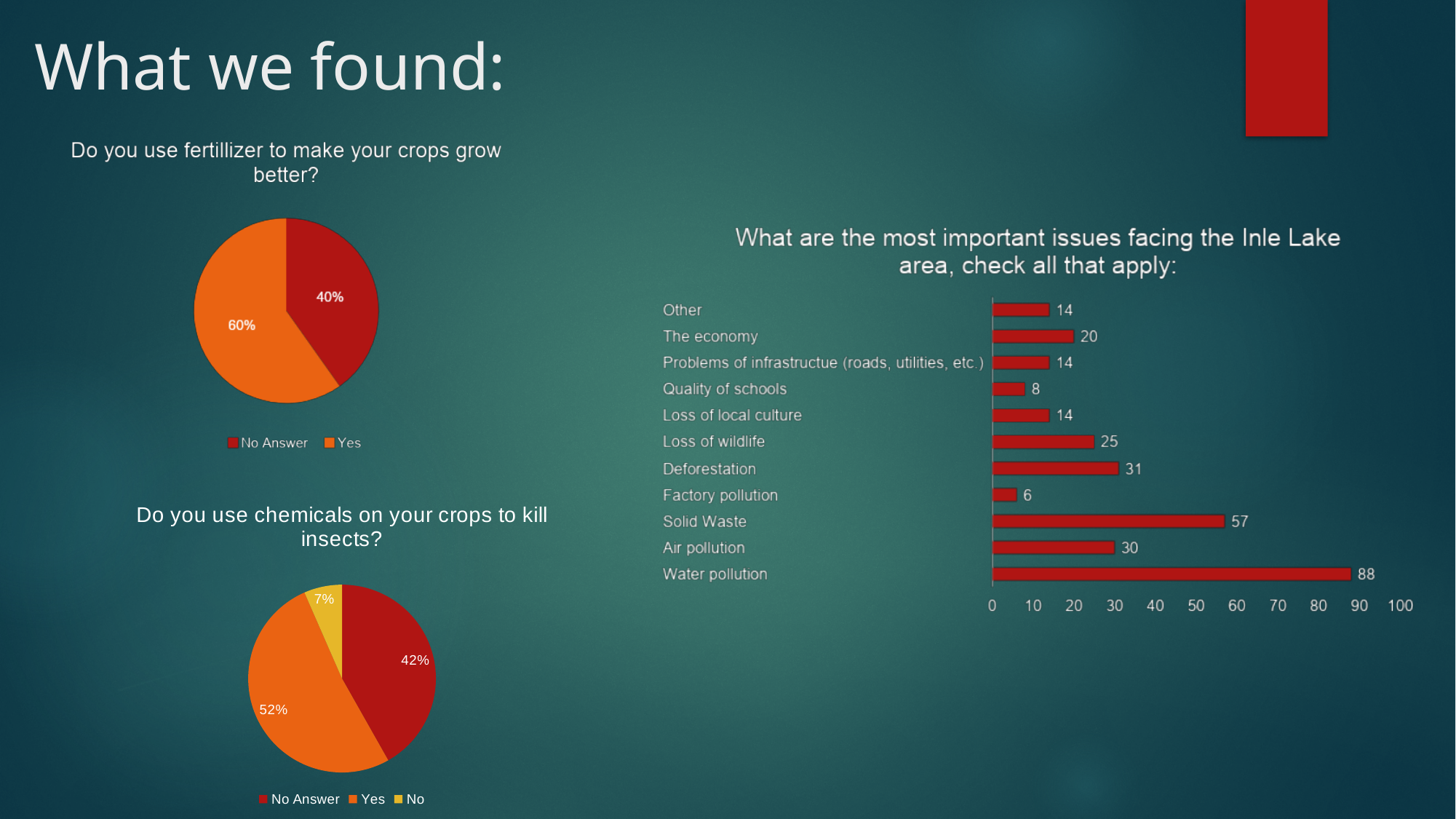
In the 'What are the most important issues facing the Inle Lake area' chart, which issue has the lowest value? Factory pollution In the 'Do you use chemicals on your crops to kill insects?' chart, what share of the pie is 'No'? 7% In the 'Do you use chemicals on your crops to kill insects?' chart, how many entries does the legend list? 3 In the 'What are the most important issues facing the Inle Lake area' chart, how many issues are listed? 11 In the 'Do you use chemicals on your crops to kill insects?' chart, which response has the largest slice? Yes In the 'What are the most important issues facing the Inle Lake area' chart, what is the value for Water pollution? 88 In the 'What are the most important issues facing the Inle Lake area' chart, what is the difference between Water pollution and Solid Waste? 31 In the 'Do you use fertillizer to make your crops grow better?' chart, what share of the pie is 'Yes'? 60% In the 'What are the most important issues facing the Inle Lake area' chart, which is larger, Deforestation or Air pollution? Deforestation What kind of chart is the 'What are the most important issues facing the Inle Lake area' chart? Bar chart In the 'What are the most important issues facing the Inle Lake area' chart, what is the value for Solid Waste? 57 In the 'Do you use fertillizer to make your crops grow better?' chart, what share of the pie is 'No Answer'? 40%